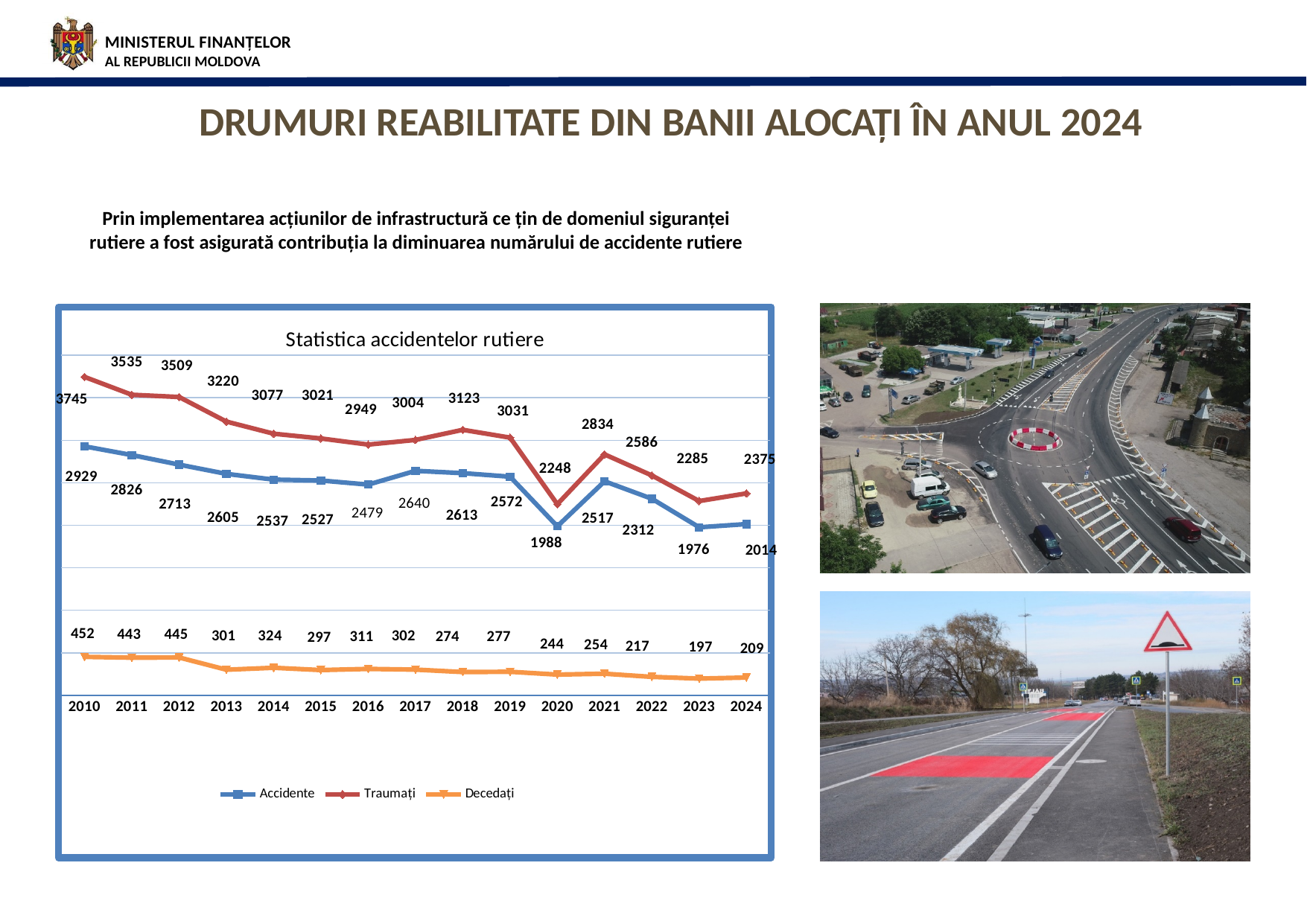
Which is larger, the Accidente value in 2021 or in 2022? 2021 What is the value of Traumați in 2010? 3745 What is the title of the chart? Statistica accidentelor rutiere What is the difference between the Traumați values in 2010 and 2024? 1370 What is the value of Accidente in 2024? 2014 Overall, does the Decedați series rise or fall from 2010 to 2024? fall In which year is the Accidente series at its lowest? 2023 What type of chart is shown on the slide? line chart How many years are plotted along the x axis of the chart? 15 In which year is the Decedați series at its highest? 2010 What is the value of Decedați in 2023? 197 How many series does the chart legend list? 3